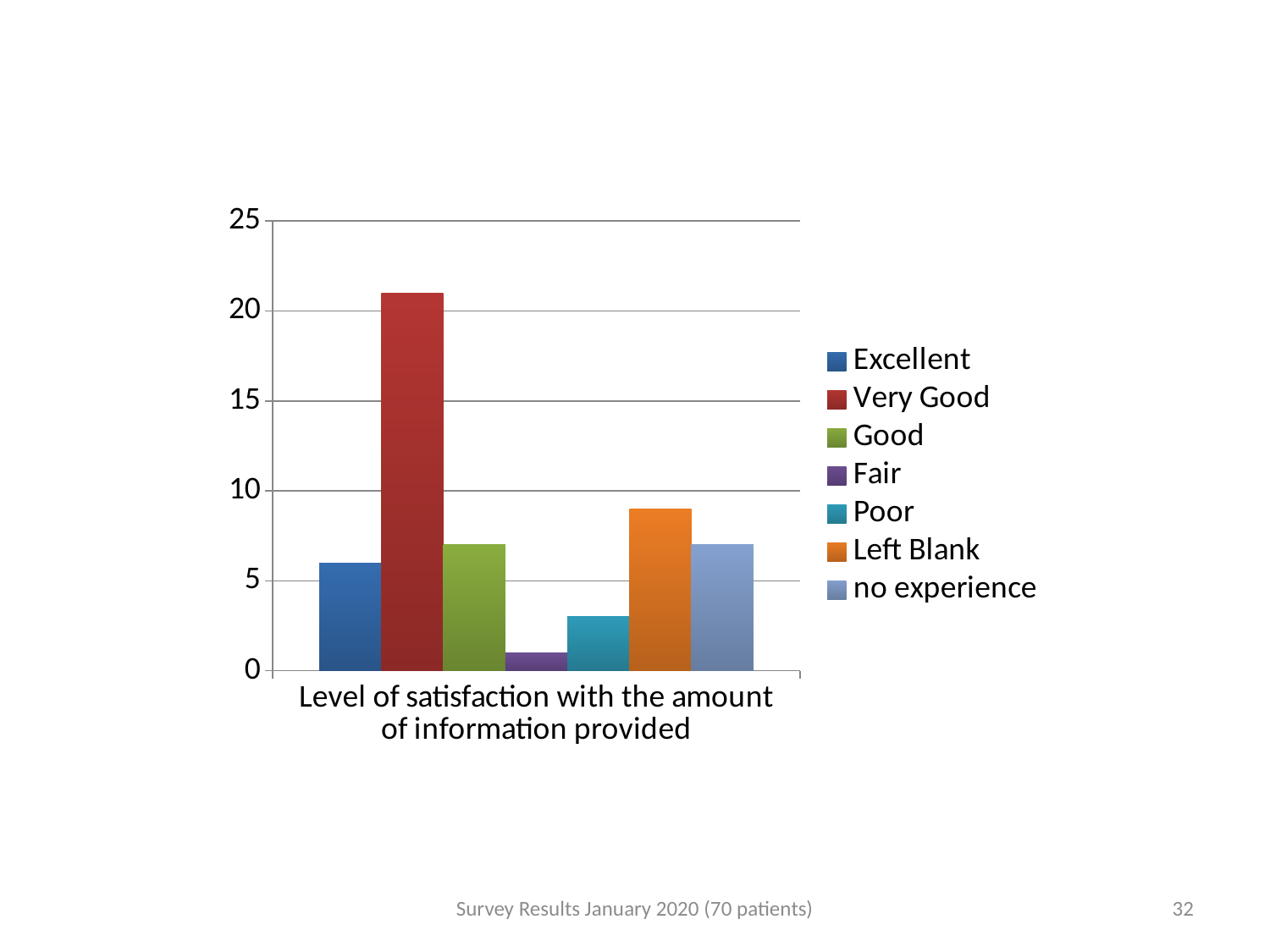
Is the value for Poor greater or less than 5? less Is the value for Very Good greater or less than 15? greater Which series is shown in orange? Left Blank Is the value for Left Blank greater or less than 10? less How many series does the legend list? 7 Which series has the highest bar? Very Good Which is larger, the value for Left Blank or the value for Poor? Left Blank Which series has the lowest bar? Fair Which is larger, the value for Very Good or the value for Excellent? Very Good What is the category label shown on the x axis? Level of satisfaction with the amount of information provided What kind of chart is shown on the slide? bar chart